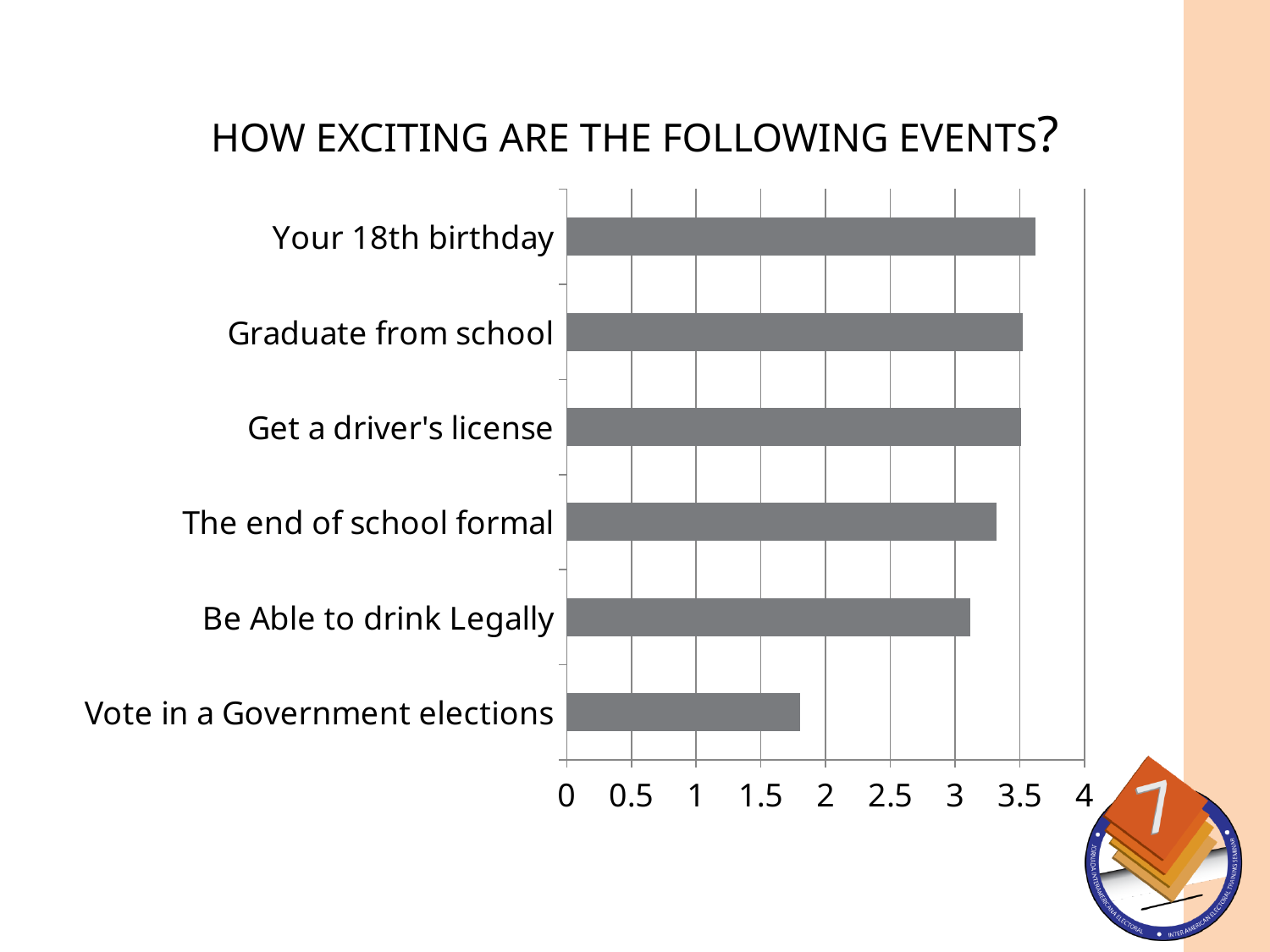
What is the maximum value shown on the horizontal axis of the chart? 4 Is the value for Your 18th birthday greater or less than 3.5? greater Is the value for Be Able to drink Legally greater or less than 3? greater Which event has the lowest excitement value in the chart? Vote in a Government elections Is the value for The end of school formal greater or less than 3.5? less What is the title of the chart? HOW EXCITING ARE THE FOLLOWING EVENTS? How many events (categories) are plotted in the chart? 6 Which has a larger value: Be Able to drink Legally or Vote in a Government elections? Be Able to drink Legally Which has a larger value: The end of school formal or Be Able to drink Legally? The end of school formal What kind of chart is shown on the slide? bar chart Which event has the highest excitement value in the chart? Your 18th birthday